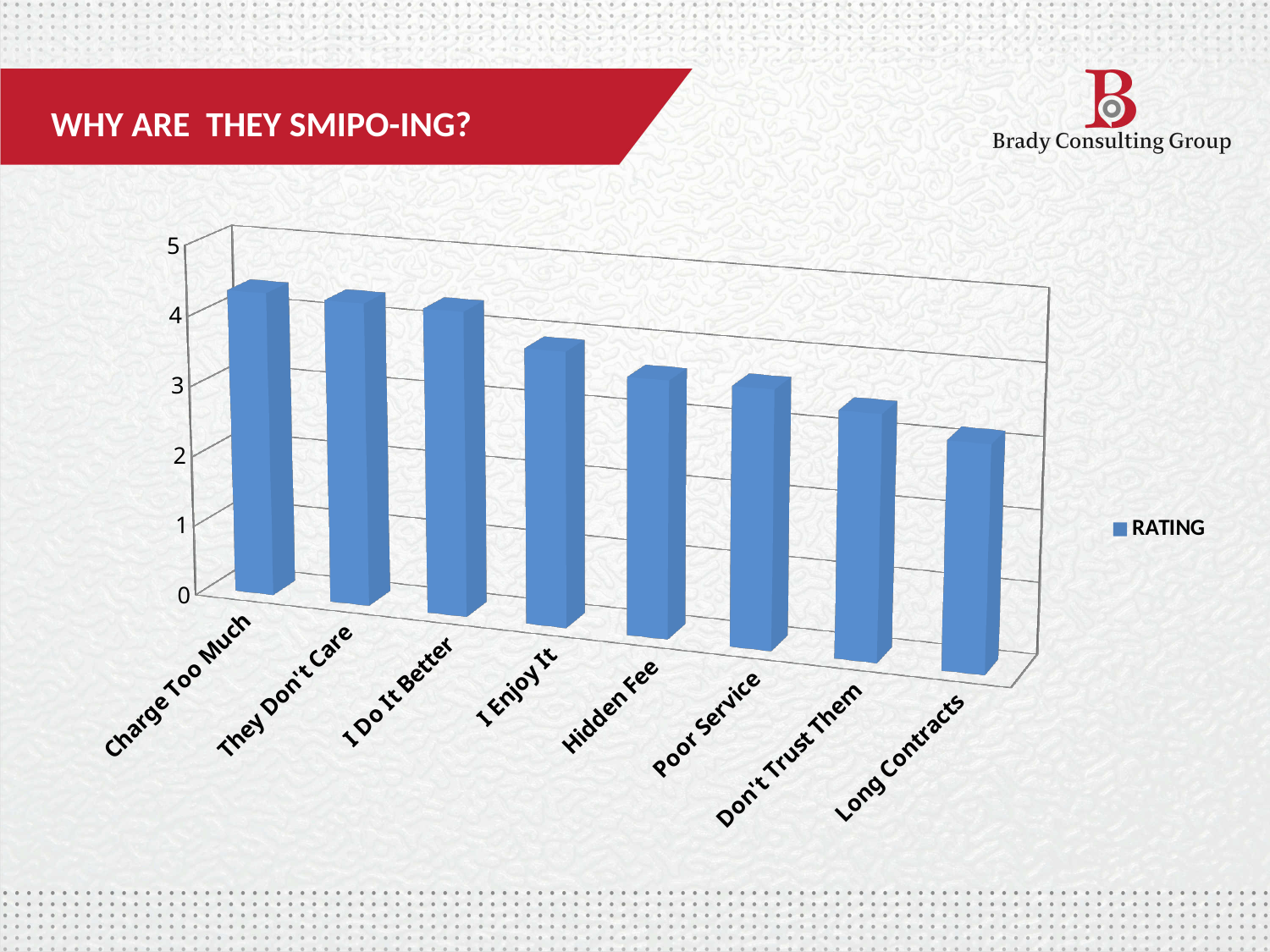
Which category has the highest rating? Charge Too Much Is the value for Charge Too Much greater or less than 4? greater How many categories are shown on the x axis of the chart? 8 How many series does the chart's legend list? 1 Which has a higher rating, I Enjoy It or Don't Trust Them? I Enjoy It What is the name of the series shown in the chart's legend? RATING Do the ratings rise or fall moving from left to right along the x axis? fall Is the value for I Enjoy It greater or less than 3? greater What kind of chart is shown on the slide? bar chart Which category has the lowest rating? Long Contracts